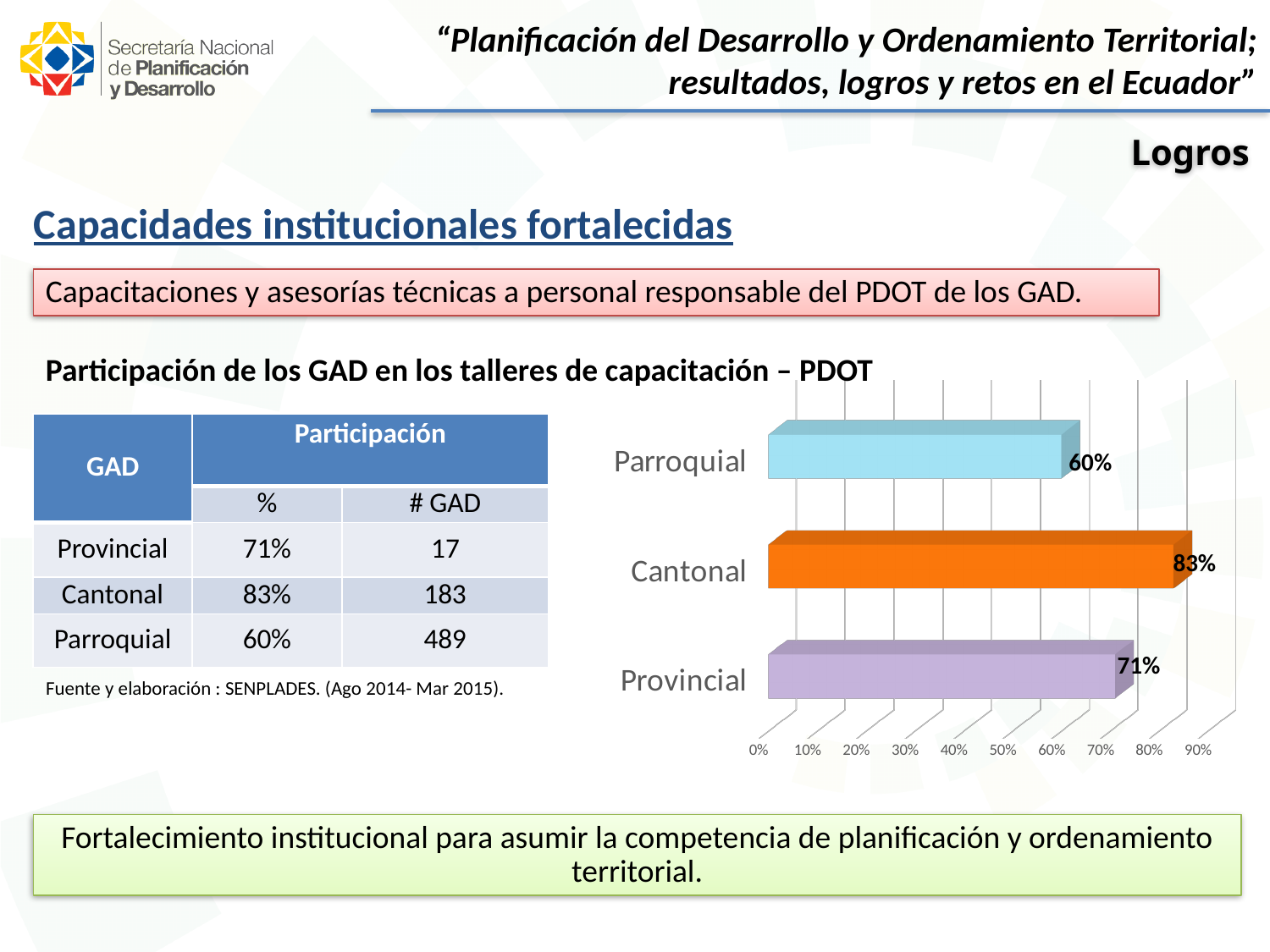
What kind of chart is shown on the slide? bar chart Which category has the highest value in the bar chart? Cantonal Which is larger in the bar chart, the value for Provincial or the value for Cantonal? Cantonal How many categories are shown in the bar chart? 3 What is the value for Cantonal in the bar chart? 83% Which category has the lowest value in the bar chart? Parroquial What colour is the bar for Cantonal in the bar chart? orange What is the difference between the values for Provincial and Parroquial in the bar chart? 11% What is the difference between the values for Cantonal and Parroquial in the bar chart? 23% What is the value for Provincial in the bar chart? 71% Is the value for Parroquial in the bar chart greater or less than 70%? less What is the value for Parroquial in the bar chart? 60%